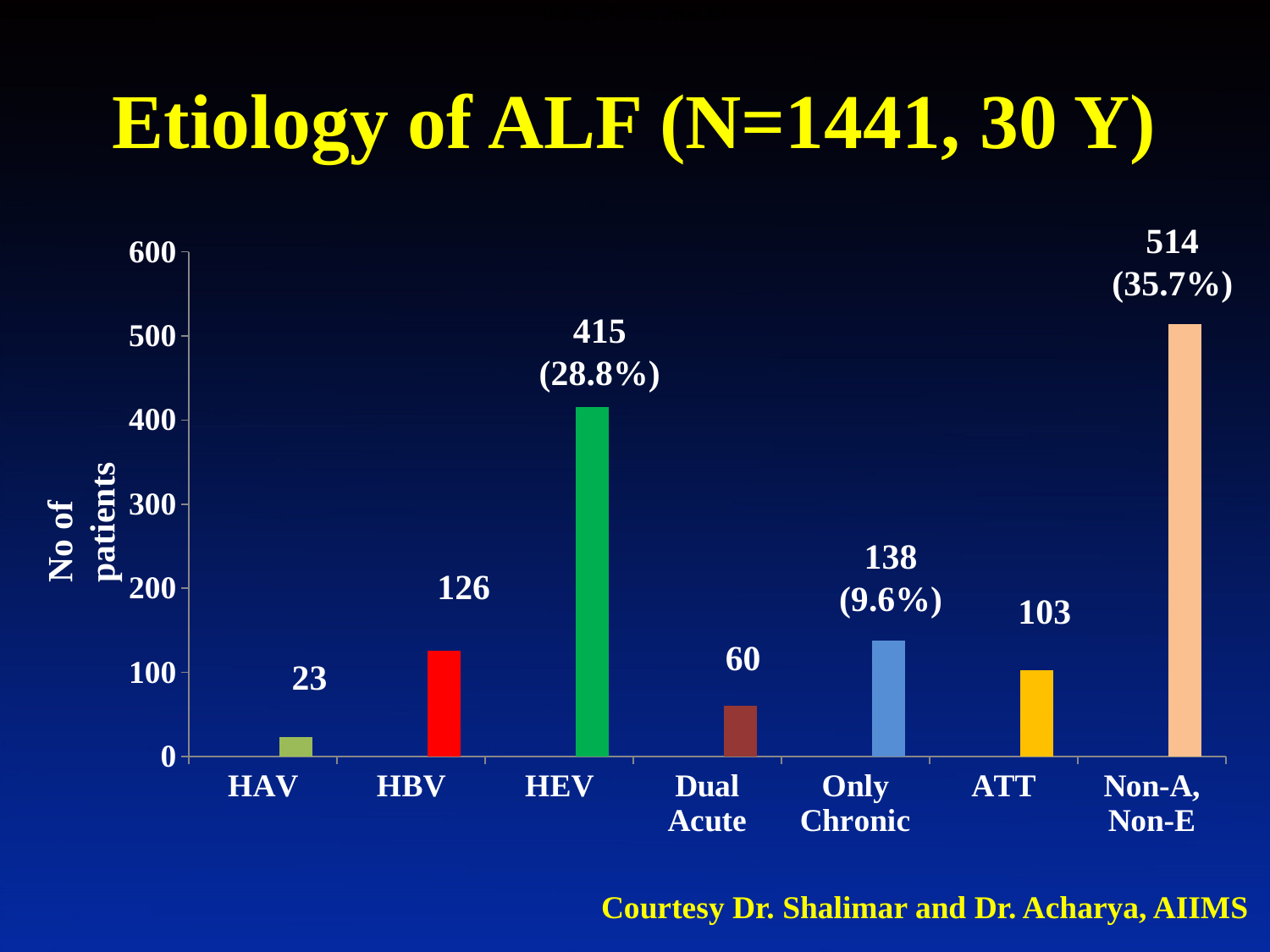
Which etiology has the lowest number of patients? HAV What percentage is shown for Only Chronic? 9.6% What is the difference in number of patients between Non-A, Non-E and HEV? 99 Which etiology has the highest number of patients? Non-A, Non-E What type of chart is shown on the slide? Bar chart What is the number of patients for Non-A, Non-E? 514 What is the title of the chart? Etiology of ALF (N=1441, 30 Y) How many etiology categories are shown on the x axis? 7 Which has more patients, HBV or ATT? HBV Is the value for Only Chronic greater or less than 100? greater What is the number of patients for HEV? 415 What is the number of patients for Dual Acute? 60